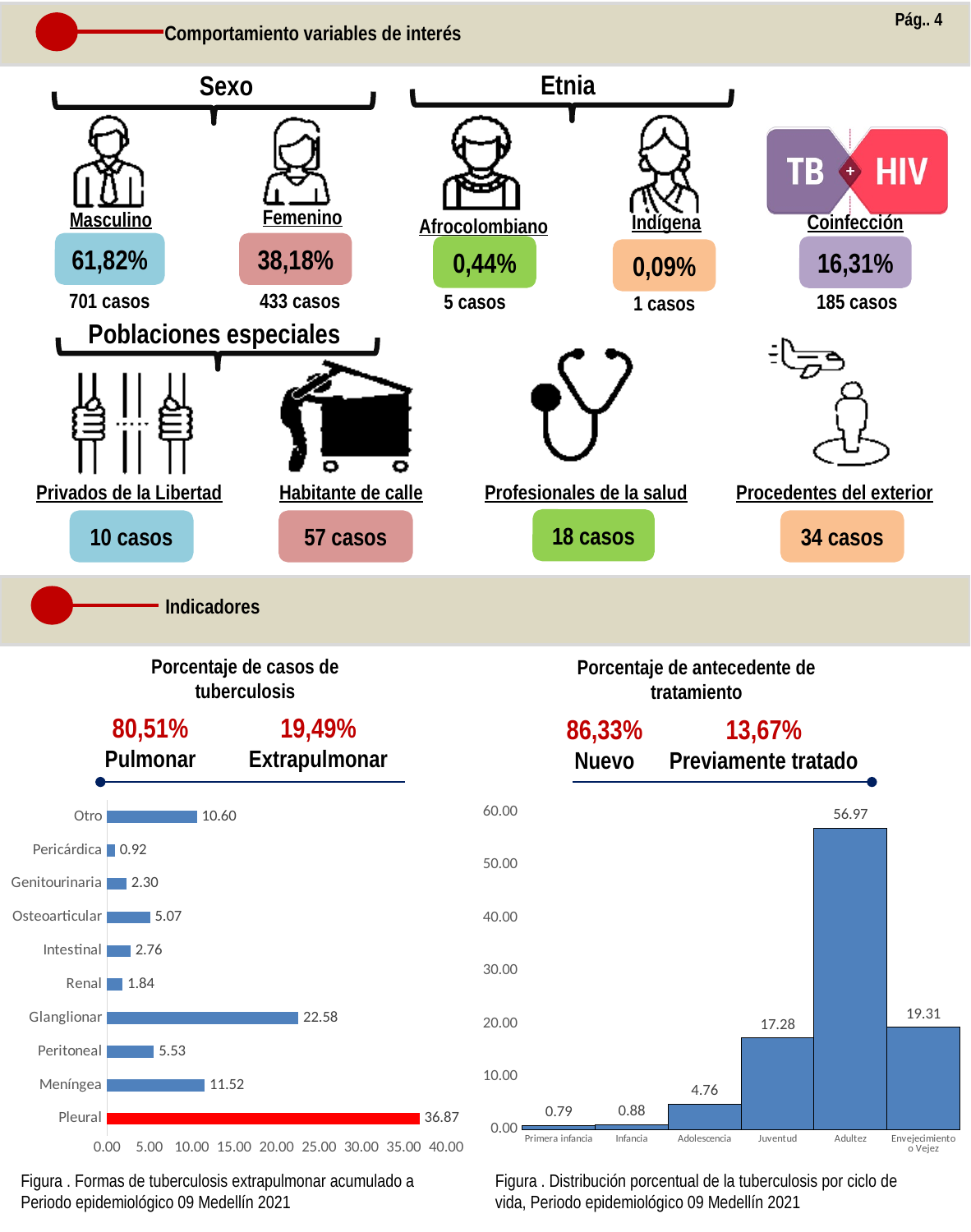
In the right chart (Distribución porcentual de la tuberculosis por ciclo de vida), what is the difference between Envejecimiento o Vejez and Juventud? 2.03 In the left chart (Formas de tuberculosis extrapulmonar), what colour is the Pleural bar? Red In the left chart (Formas de tuberculosis extrapulmonar), which is larger, Osteoarticular or Peritoneal? Peritoneal In the left chart (Formas de tuberculosis extrapulmonar), what is the value for Glanglionar? 22.58 In the left chart (Formas de tuberculosis extrapulmonar), which category has the highest value? Pleural In the right chart (Distribución porcentual de la tuberculosis por ciclo de vida), which category has the lowest value? Primera infancia In the left chart (Formas de tuberculosis extrapulmonar), how many categories are plotted? 10 In the right chart (Distribución porcentual de la tuberculosis por ciclo de vida), what is the value for Adultez? 56.97 In the left chart (Formas de tuberculosis extrapulmonar), what is the difference between the values for Pleural and Meníngea? 25.35 In the right chart (Distribución porcentual de la tuberculosis por ciclo de vida), how many categories are shown on the x axis? 6 What type of chart is the right chart (Distribución porcentual de la tuberculosis por ciclo de vida)? Bar chart In the left chart (Formas de tuberculosis extrapulmonar), which category has the lowest value? Pericárdica